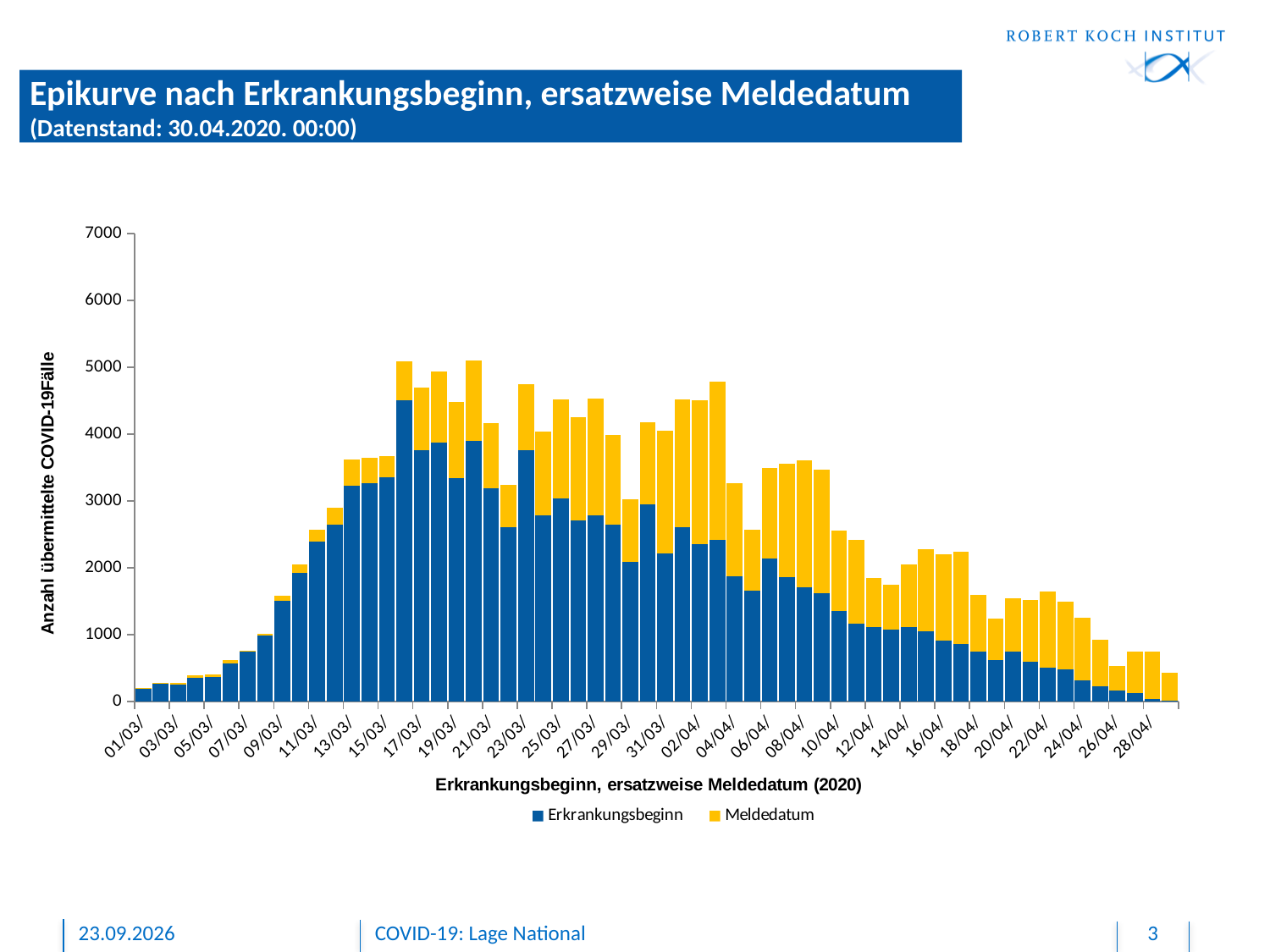
Is the total bar height for 13/03 greater or less than 3000? greater What is the title of the y axis? Anzahl übermittelte COVID-19Fälle What kind of chart is shown on the slide? bar chart How many series does the legend list? 2 Is the total bar height for 28/04 greater or less than 1000? less Do the total bar heights rise or fall from 17/04 to 28/04? fall Do the total bar heights rise or fall from 01/03 to 15/03? rise Is the total bar height for 17/03 greater or less than 4000? greater What are the two series named in the legend? Erkrankungsbeginn and Meldedatum Which date has the larger total bar, 17/03 or 01/03? 17/03